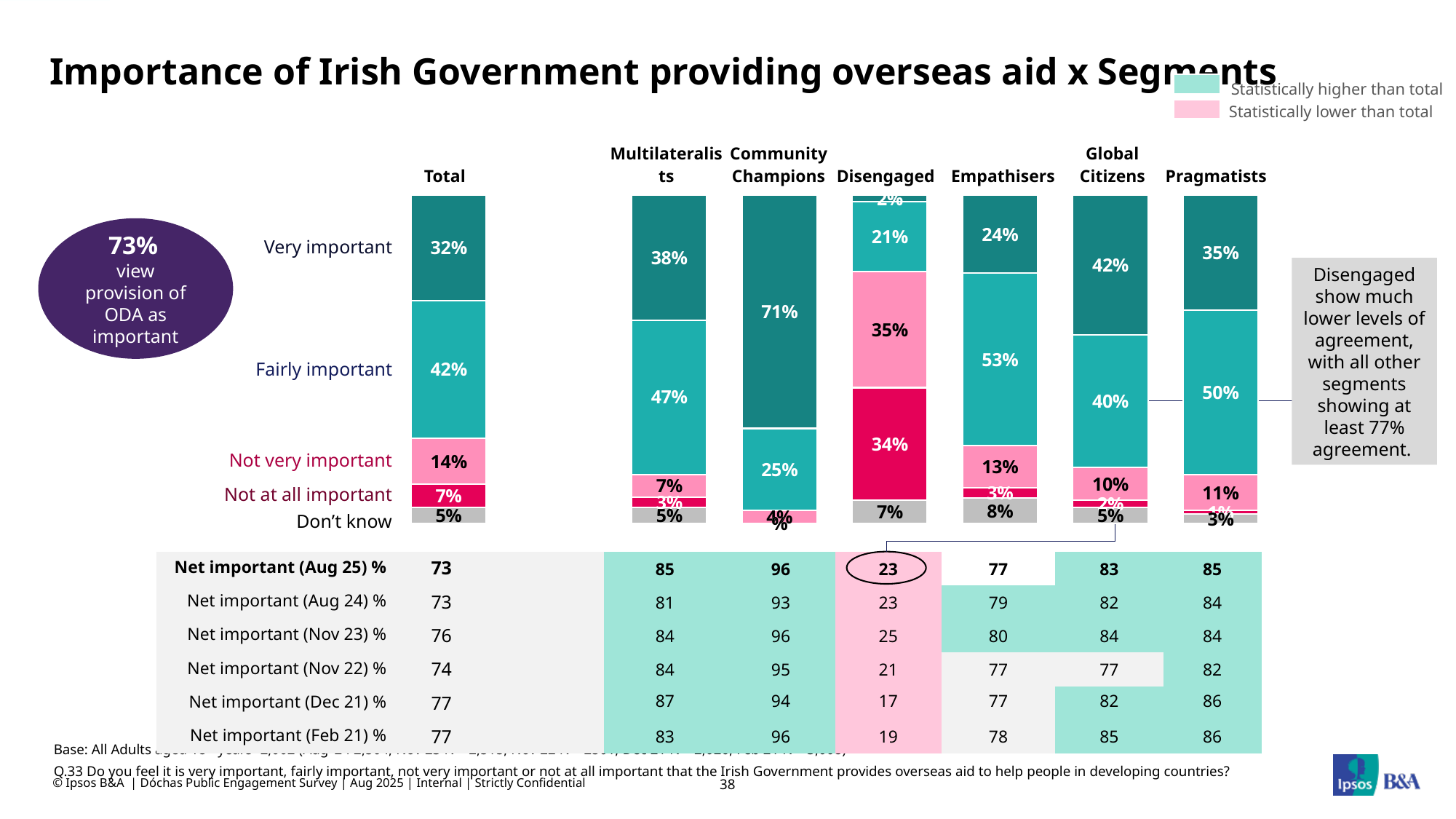
Which is larger: the Very important percentage for Multilateralists or for Global Citizens? Global Citizens What is the Net important (Aug 25) % for the Disengaged segment? 23 What is the difference between the Fairly important percentages for Pragmatists and Global Citizens? 10% What is the combined Very important and Fairly important percentage for the Total group? 74% What percentage of the Total group say providing overseas aid is Very important? 32% Which segment has the lowest Very important percentage? Disengaged What percentage of Community Champions say providing overseas aid is Very important? 71% What percentage of Empathisers say providing overseas aid is Fairly important? 53% What percentage of the Disengaged segment say providing overseas aid is Not at all important? 34% Which segment has the highest Very important percentage? Community Champions How many segment bars are shown in the chart, including Total? 7 What type of chart is used to show the importance ratings by segment? Stacked bar chart